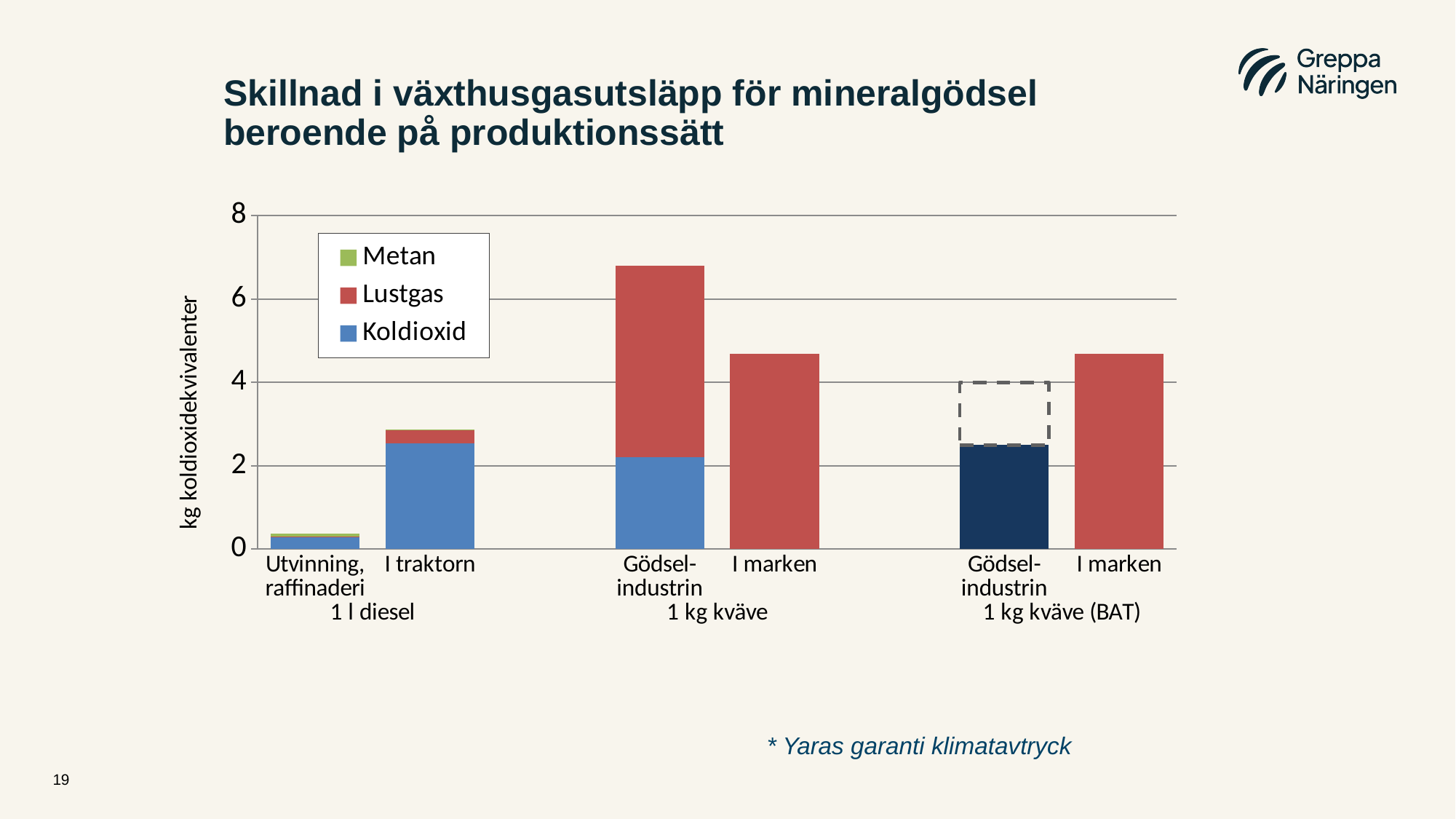
Is the value for Utvinning, raffinaderi greater or less than 2? less Is the total value for Gödselindustrin under 1 kg kväve greater or less than 6? greater Which bar is the lowest in the chart? Utvinning, raffinaderi Is the value for I marken under 1 kg kväve greater or less than 4? greater What kind of chart is shown on the slide? Stacked bar chart Which is larger, the bar for I traktorn or the bar for Gödselindustrin under 1 kg kväve? Gödselindustrin (1 kg kväve) Which bar is the highest in the chart? Gödselindustrin (1 kg kväve) How many series does the legend list? 3 How many bars are plotted in the chart? 6 Which series are listed in the legend? Metan, Lustgas, Koldioxid What is the label of the vertical axis? kg koldioxidekvivalenter